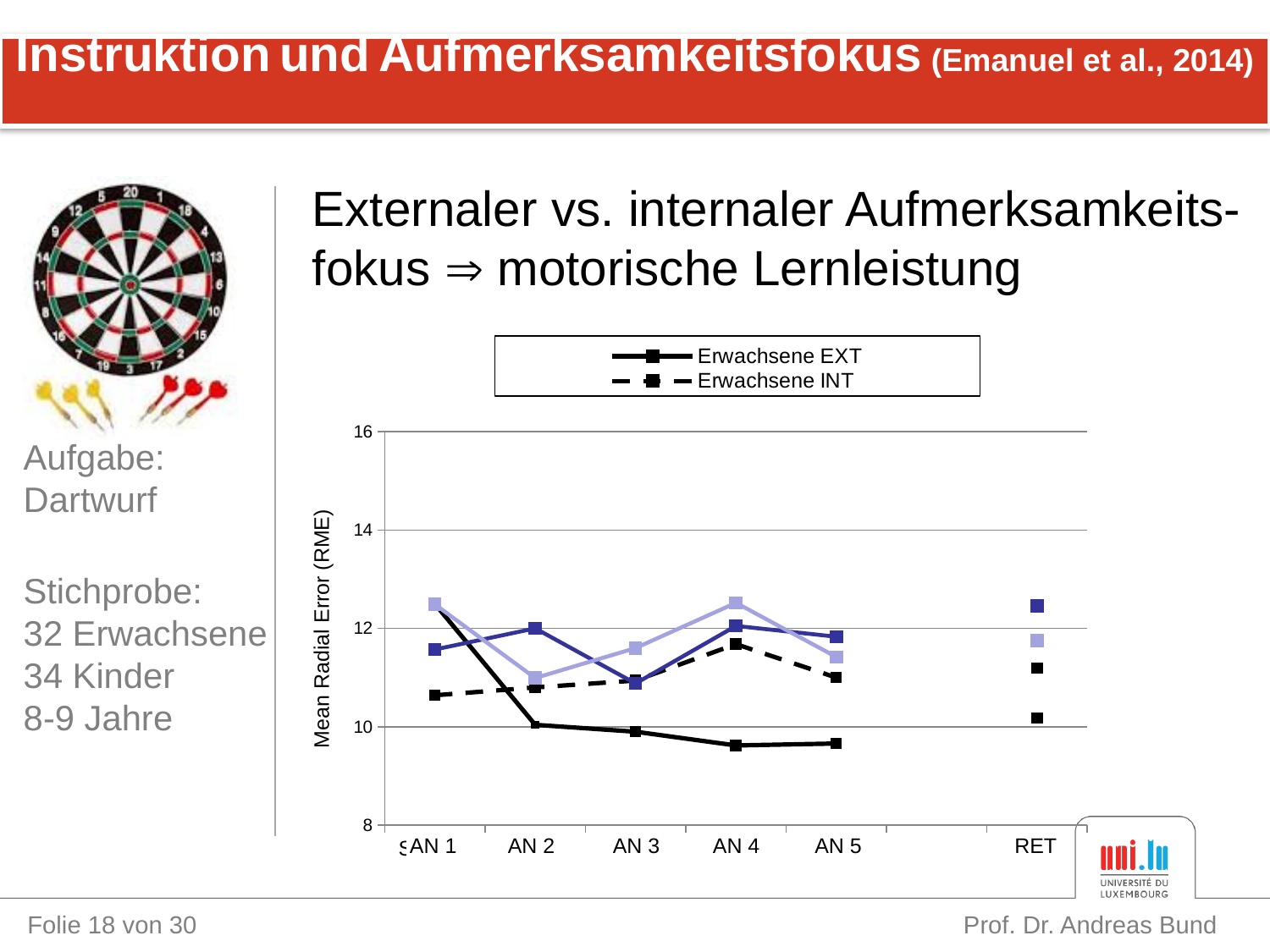
Is the value for Erwachsene INT at AN 1 greater or less than 12? less Is the value for Erwachsene EXT at AN 4 greater or less than 10? less At AN 5, which series has the larger value, Erwachsene EXT or Erwachsene INT? Erwachsene INT At which x-axis category does the Erwachsene EXT series reach its highest value? AN 1 What is the label of the y axis of the chart? Mean Radial Error (RME) Is the value for Erwachsene EXT at AN 1 greater or less than 12? greater What kind of chart is shown on the slide? line chart Does the Erwachsene EXT series rise or fall from AN 1 to AN 5? fall How many series does the chart's legend list? 2 How many categories are labelled along the x axis of the chart? 6 Which series is shown with a dashed line in the legend? Erwachsene INT